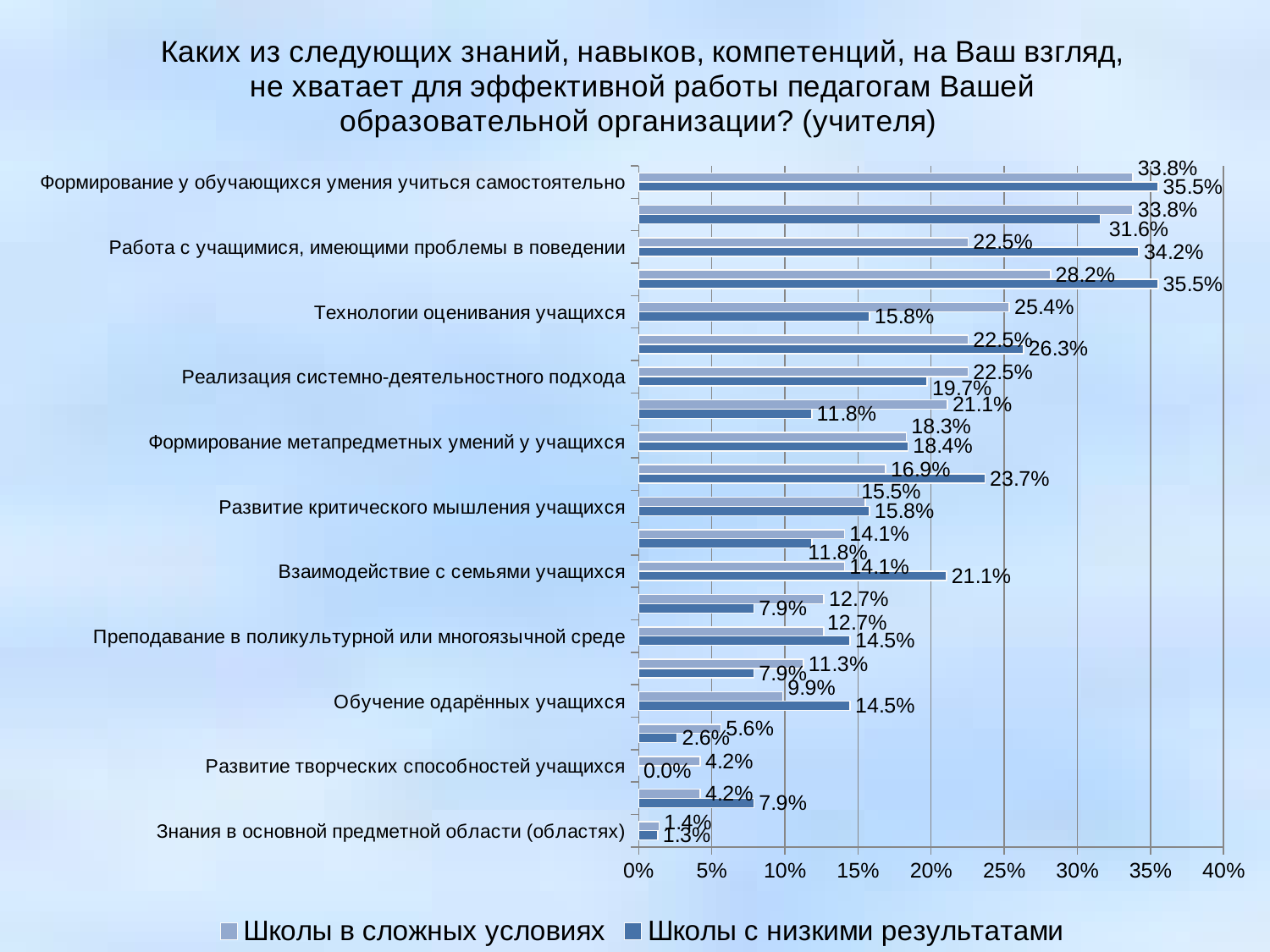
What is the value for "Школы с низкими результатами" for "Работа с учащимися, имеющими проблемы в поведении"? 34.2% Which labelled category has the lowest value for "Школы с низкими результатами"? Развитие творческих способностей учащихся Which series is shown in the darker blue colour? Школы с низкими результатами For "Обучение одарённых учащихся", which series has the larger value? Школы с низкими результатами What is the value for "Школы с низкими результатами" for "Развитие творческих способностей учащихся"? 0.0% What is the difference between the two series for "Работа с учащимися, имеющими проблемы в поведении"? 11.7% How many series does the legend list? 2 For "Технологии оценивания учащихся", which series has the larger value? Школы в сложных условиях What is the value for "Школы в сложных условиях" for "Технологии оценивания учащихся"? 25.4% What is the value for "Школы в сложных условиях" for "Взаимодействие с семьями учащихся"? 14.1% What kind of chart is shown on the slide? bar chart Which labelled category has the highest value for "Школы в сложных условиях"? Формирование у обучающихся умения учиться самостоятельно